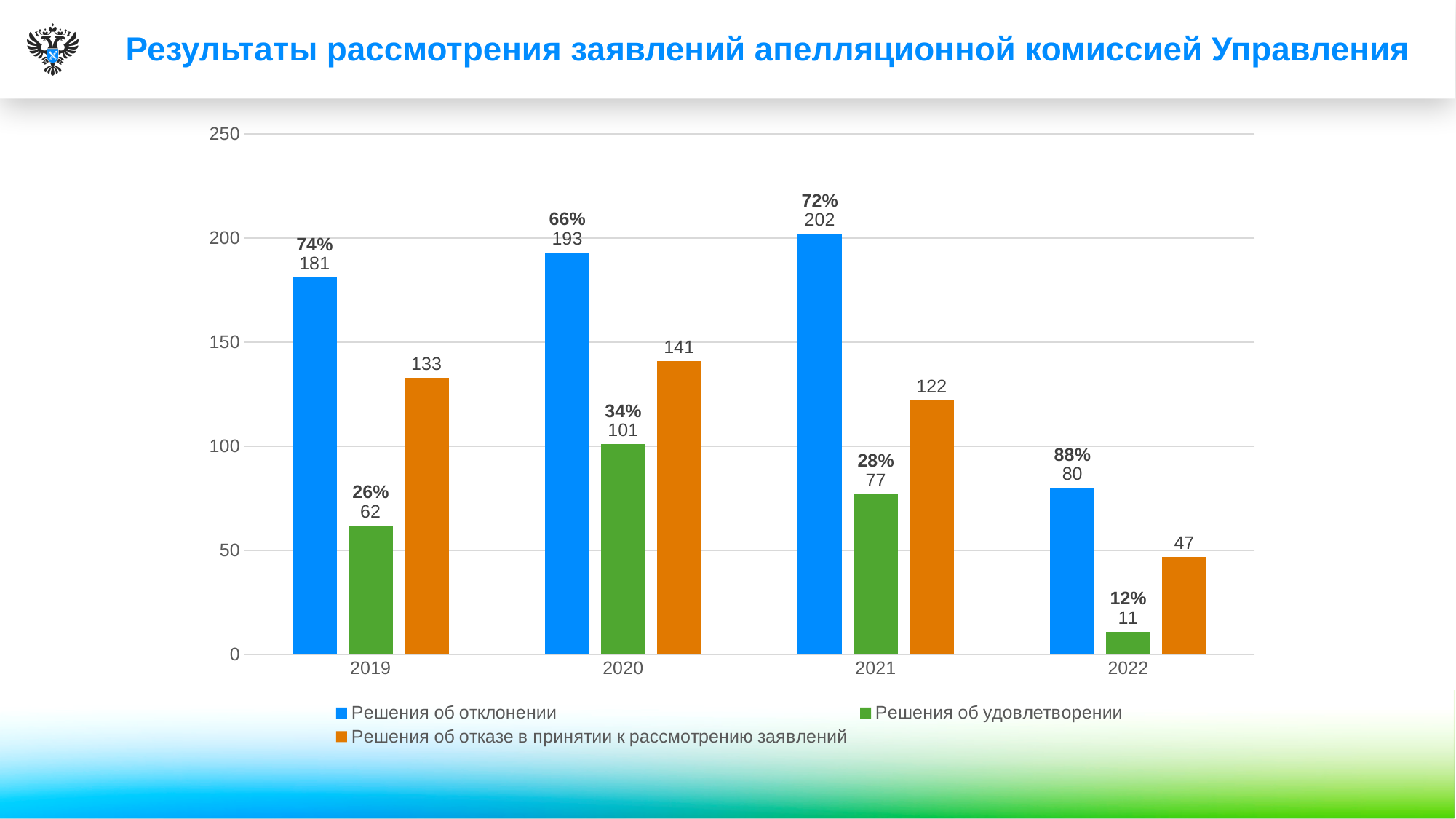
What kind of chart is shown on the slide? Bar chart In which year is the value for 'Решения об удовлетворении' lowest? 2022 In which year is the value for 'Решения об отклонении' highest? 2021 What is the value for 'Решения об отклонении' in 2021? 202 What is the value for 'Решения об удовлетворении' in 2020? 101 How many years are shown on the x axis? 4 How many series does the legend list? 3 What is the difference between 'Решения об отклонении' and 'Решения об отказе в принятии к рассмотрению заявлений' in 2020? 52 Does the value for 'Решения об отказе в принятии к рассмотрению заявлений' rise or fall from 2021 to 2022? Fall Which is larger in 2019: 'Решения об удовлетворении' or 'Решения об отказе в принятии к рассмотрению заявлений'? Решения об отказе в принятии к рассмотрению заявлений What percentage is shown above the 'Решения об удовлетворении' bar for 2019? 26% What is the value for 'Решения об отказе в принятии к рассмотрению заявлений' in 2022? 47